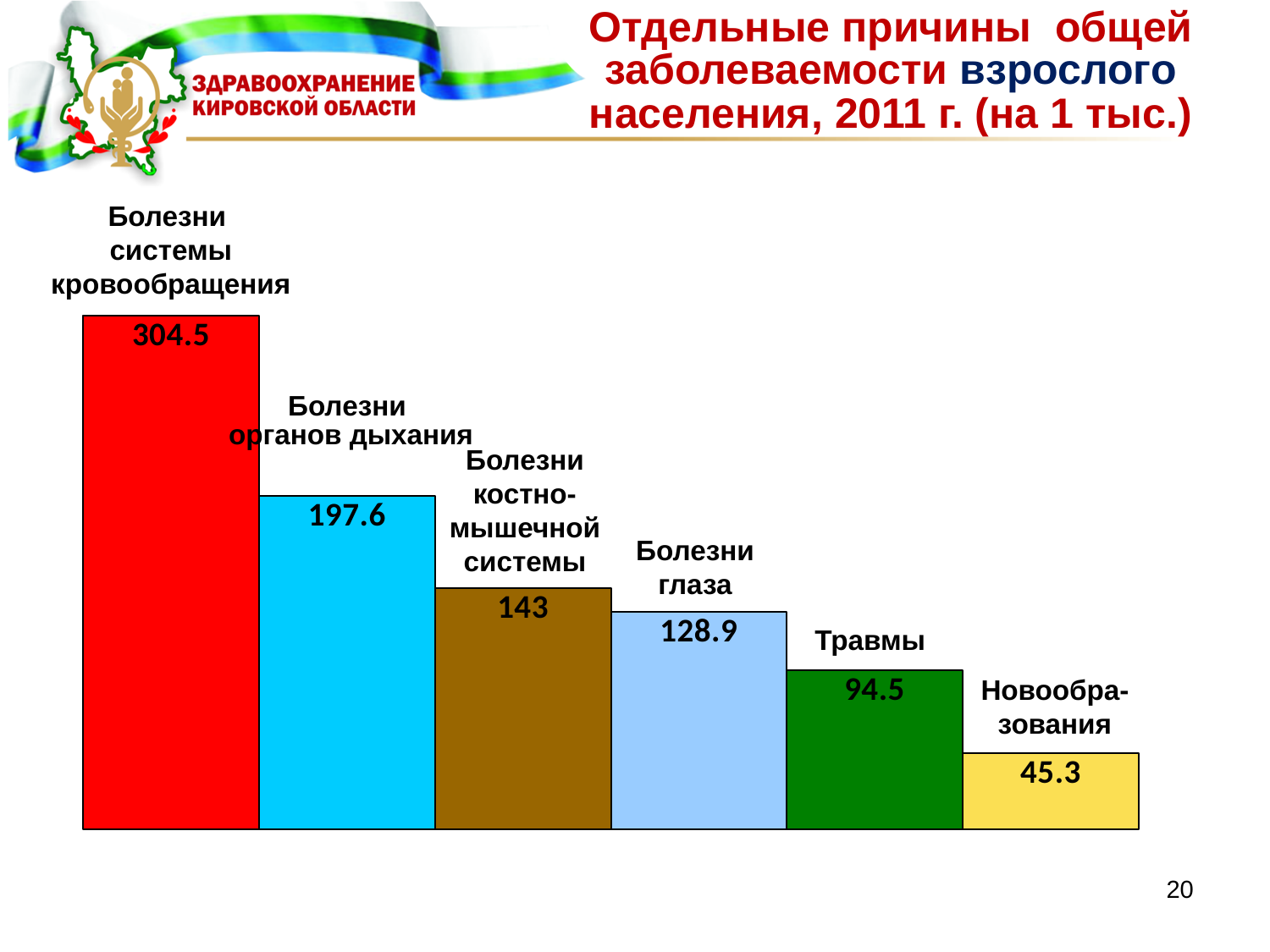
What kind of chart is shown on the slide? Bar chart Which category has the lowest value? Новообразования What is the value for Болезни костно-мышечной системы? 143 What is the difference between the values for Болезни системы кровообращения and Болезни органов дыхания? 106.9 What is the value for Новообразования? 45.3 Which category has the highest value? Болезни системы кровообращения What is the value for Болезни системы кровообращения? 304.5 How many categories are shown in the chart? 6 What is the difference between the values for Болезни глаза and Травмы? 34.4 What is the value for Болезни органов дыхания? 197.6 What is the value for Травмы? 94.5 Which is larger, the value for Болезни костно-мышечной системы or the value for Болезни глаза? Болезни костно-мышечной системы